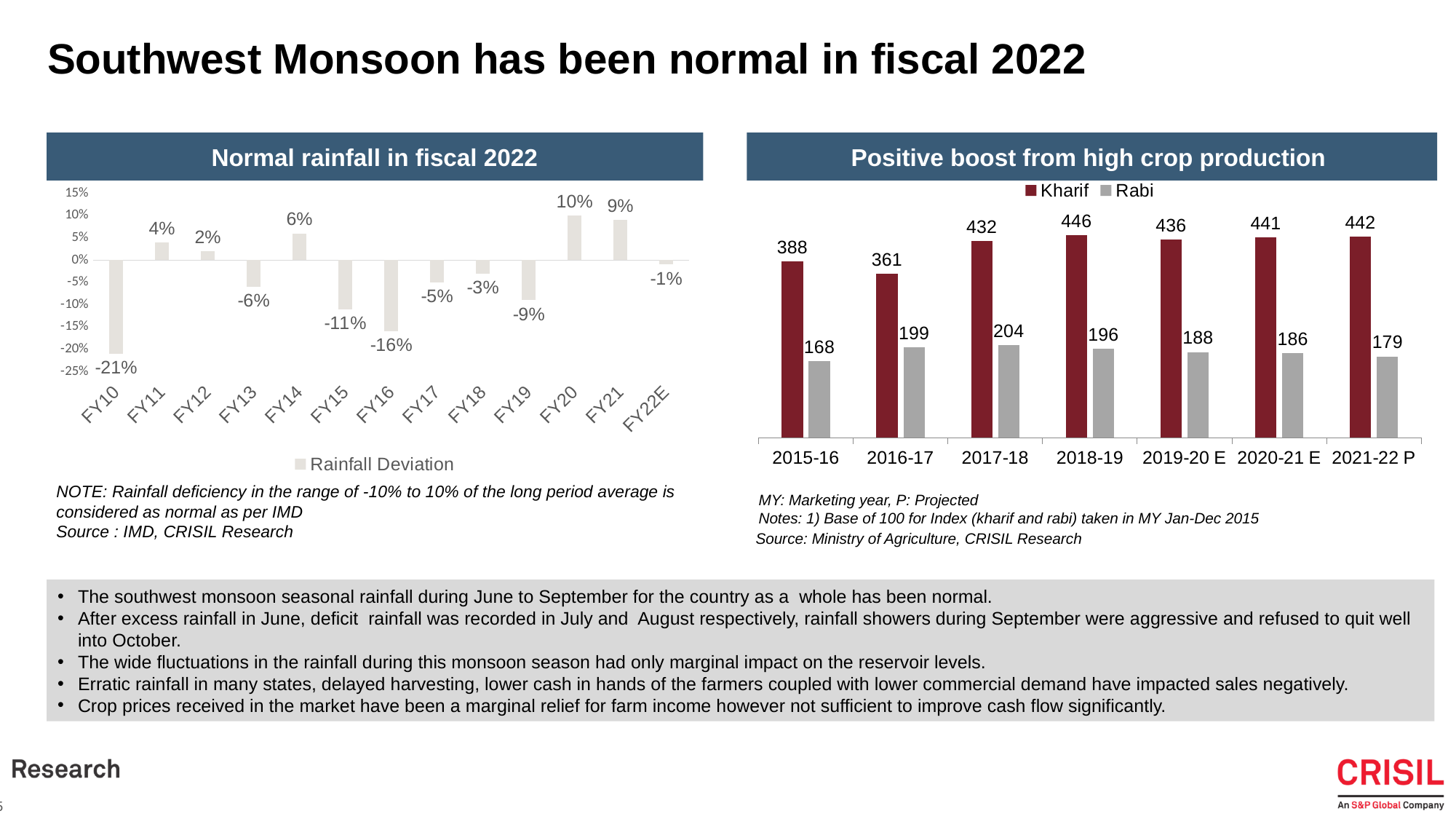
In the 'Positive boost from high crop production' chart, what is the Rabi value for 2021-22 P? 179 In the 'Positive boost from high crop production' chart, which year has the highest Rabi value? 2017-18 In the 'Normal rainfall in fiscal 2022' chart, what is the rainfall deviation for FY16? -16% In the 'Normal rainfall in fiscal 2022' chart, which fiscal year has the highest rainfall deviation? FY20 In the 'Positive boost from high crop production' chart, what is the difference between the Kharif and Rabi values for 2015-16? 220 In the 'Positive boost from high crop production' chart, how many series does the legend list? 2 In the 'Normal rainfall in fiscal 2022' chart, what is the rainfall deviation for FY22E? -1% In the 'Positive boost from high crop production' chart, what is the Kharif value for 2018-19? 446 What kind of chart is the 'Positive boost from high crop production' chart? Bar chart In the 'Normal rainfall in fiscal 2022' chart, how many fiscal years are shown on the x axis? 13 In the 'Normal rainfall in fiscal 2022' chart, which fiscal year has the lowest rainfall deviation? FY10 In the 'Normal rainfall in fiscal 2022' chart, what is the difference between the rainfall deviation in FY20 and FY21? 1 percentage point